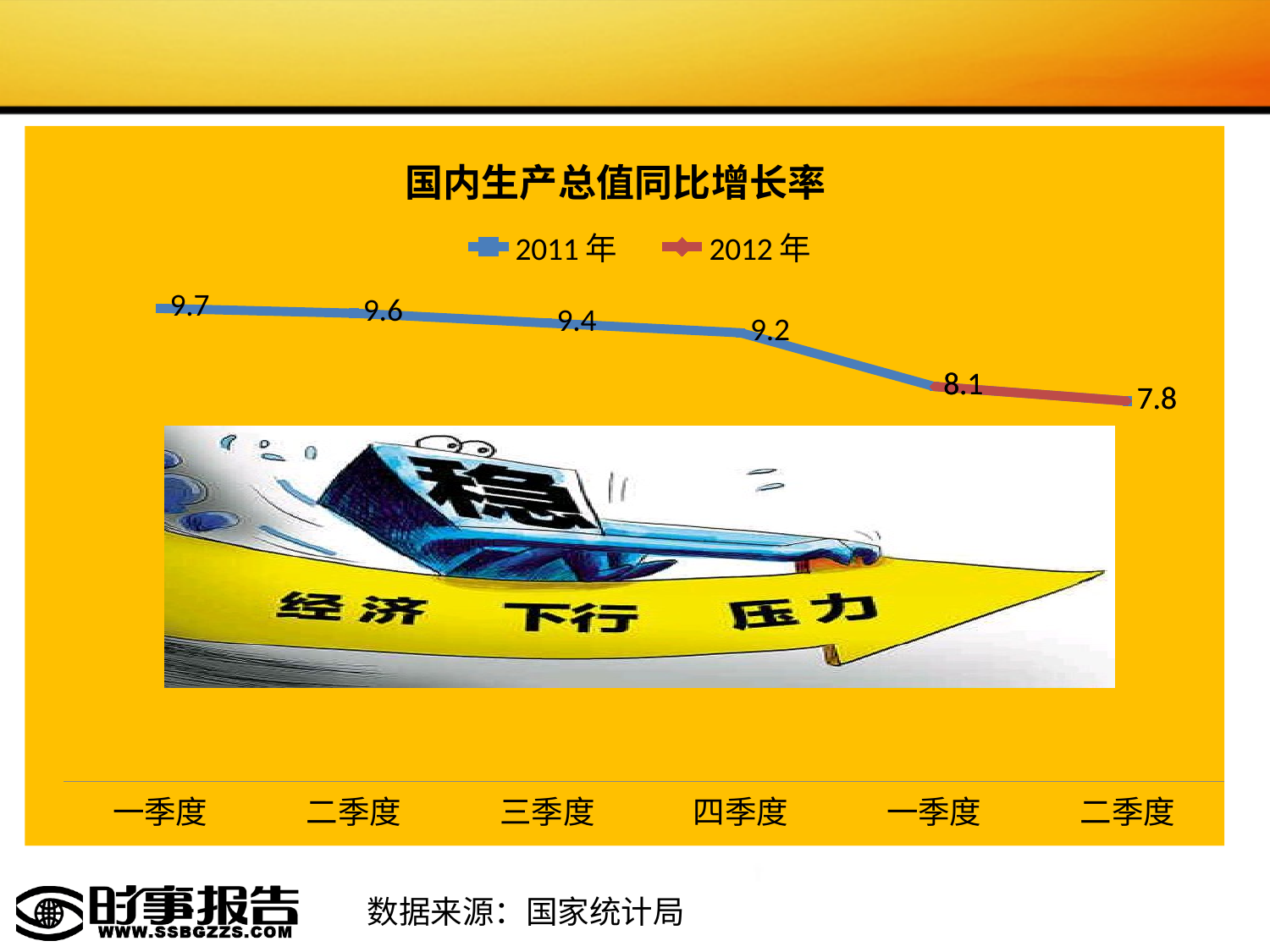
What is the value for 三季度? 9.4 What is the title of the chart? 国内生产总值同比增长率 Do the values rise or fall from left to right along the x axis? fall What is the value for the first 二季度 (second point from the left)? 9.6 What kind of chart is shown on the slide? line chart What is the difference between the leftmost value (9.7) and the rightmost value (7.8)? 1.9 What is the value for the last 二季度 (rightmost point) on the chart? 7.8 What is the value for 四季度? 9.2 How many series does the chart legend list? 2 What is the value for the first 一季度 (leftmost point) on the chart? 9.7 Which point on the chart has the highest value? the first 一季度 (9.7) Which point on the chart has the lowest value? the last 二季度 (7.8)